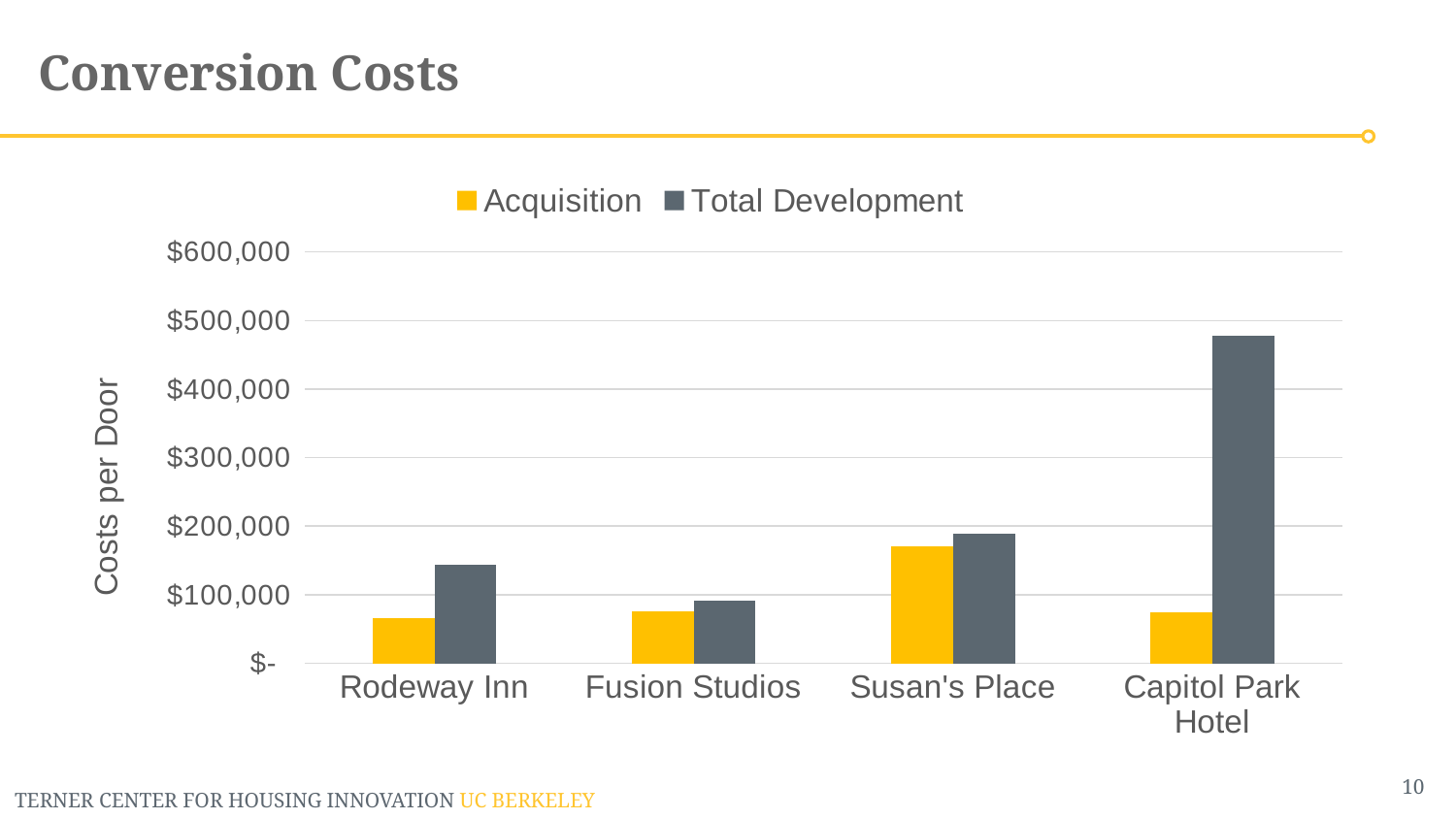
Which property has the highest Acquisition cost per door? Susan's Place Is the Acquisition value for Susan's Place greater or less than $100,000? greater Is the Total Development value for Fusion Studios greater or less than $100,000? less What is the label on the y axis? Costs per Door Which property has the highest Total Development cost per door? Capitol Park Hotel Is the Total Development value for Rodeway Inn greater or less than $100,000? greater How many properties are shown on the x axis? 4 Which property has the lowest Total Development cost per door? Fusion Studios What kind of chart is shown on the slide? bar chart How many series does the legend list? 2 Which is larger: the Total Development value for Capitol Park Hotel or for Susan's Place? Capitol Park Hotel